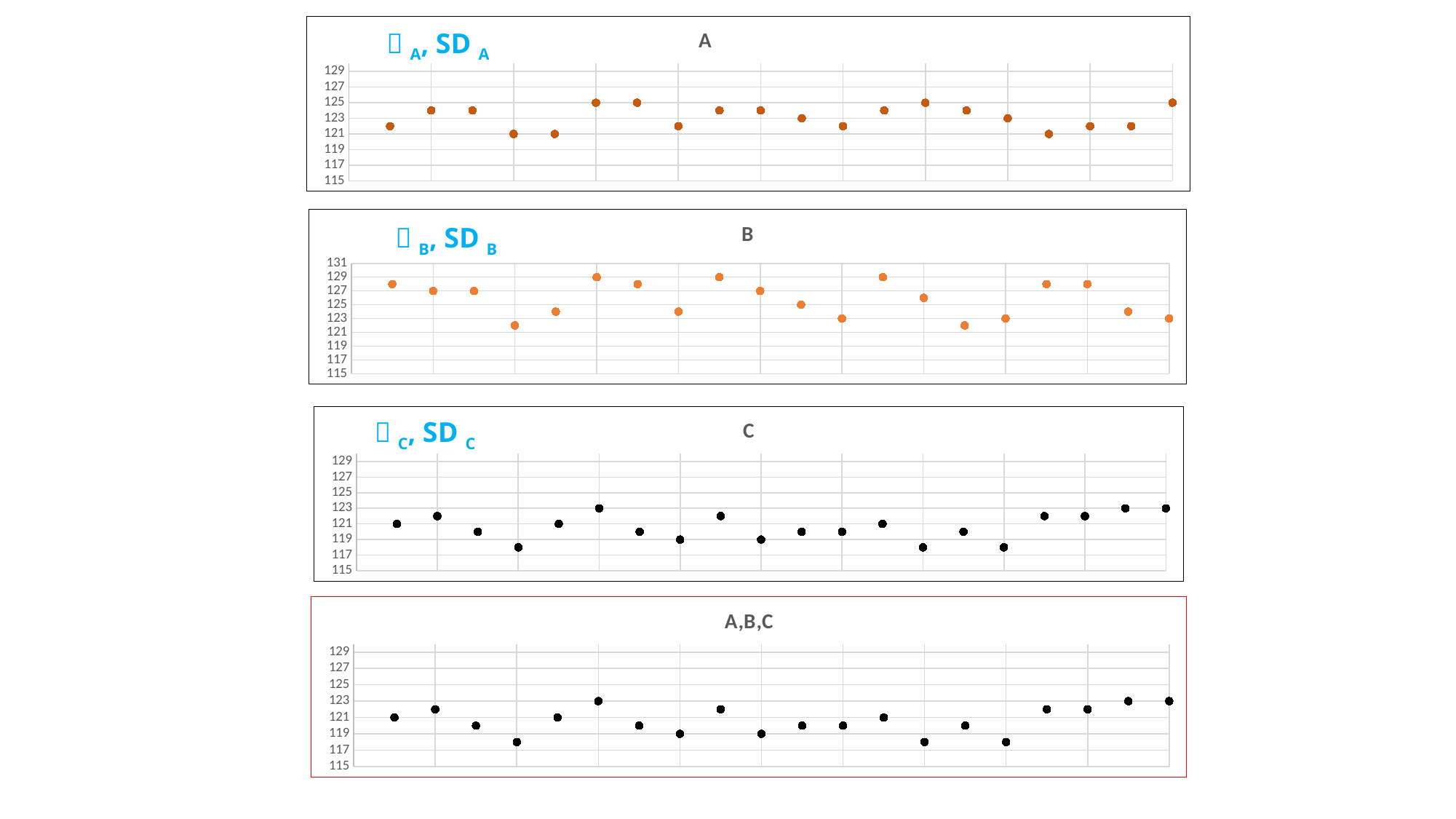
In the chart titled A, is the value of the sixth point greater or less than 123? greater In the chart titled B, is the value of the fourth point greater or less than 125? less In the chart titled C, is the value of the fourth point greater or less than 121? less How many data points are plotted in the chart titled B? 20 In the chart titled A, what is the highest value reached by any point? 125 How many data points are plotted in the chart titled A? 20 What is the highest value shown on the vertical axis of the chart titled B? 131 In the chart titled B, what is the highest value reached by any point? 129 How many data points are plotted in the chart titled C? 20 What is the title of the bottom chart on the slide? A,B,C What kind of chart is the chart titled A? scatter chart